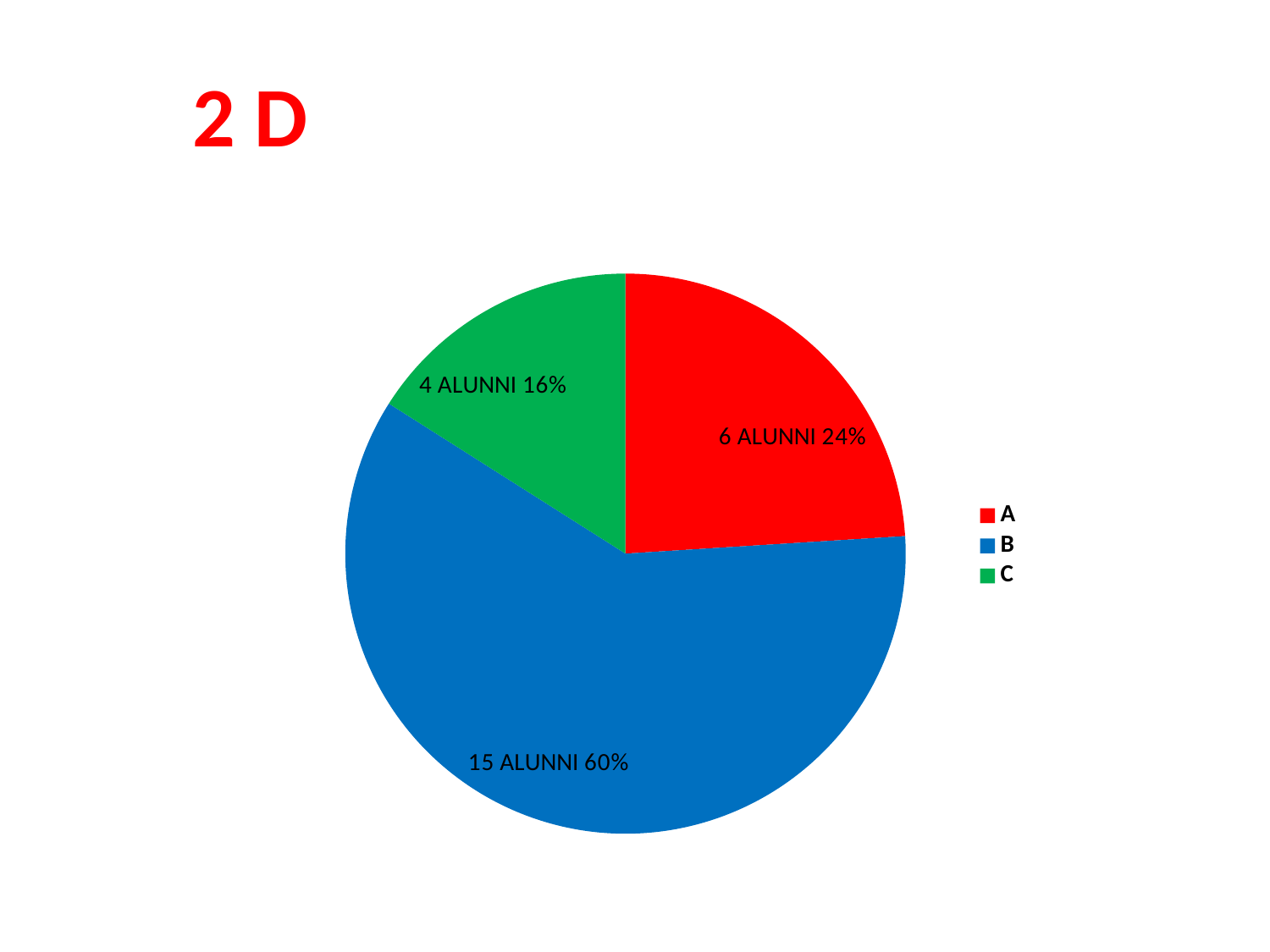
What percentage share does slice A have? 24% Which colour represents category C in the legend? green How many alunni are in category C? 4 ALUNNI Which category has the smallest slice? C How many entries does the legend list? 3 What percentage share does slice B have? 60% Which category has the largest slice? B How many slices does the pie chart have? 3 How many alunni are in category B? 15 ALUNNI What percentage share does slice C have? 16% What is the difference in alunni between category B and category A? 9 What kind of chart is shown on the slide? pie chart